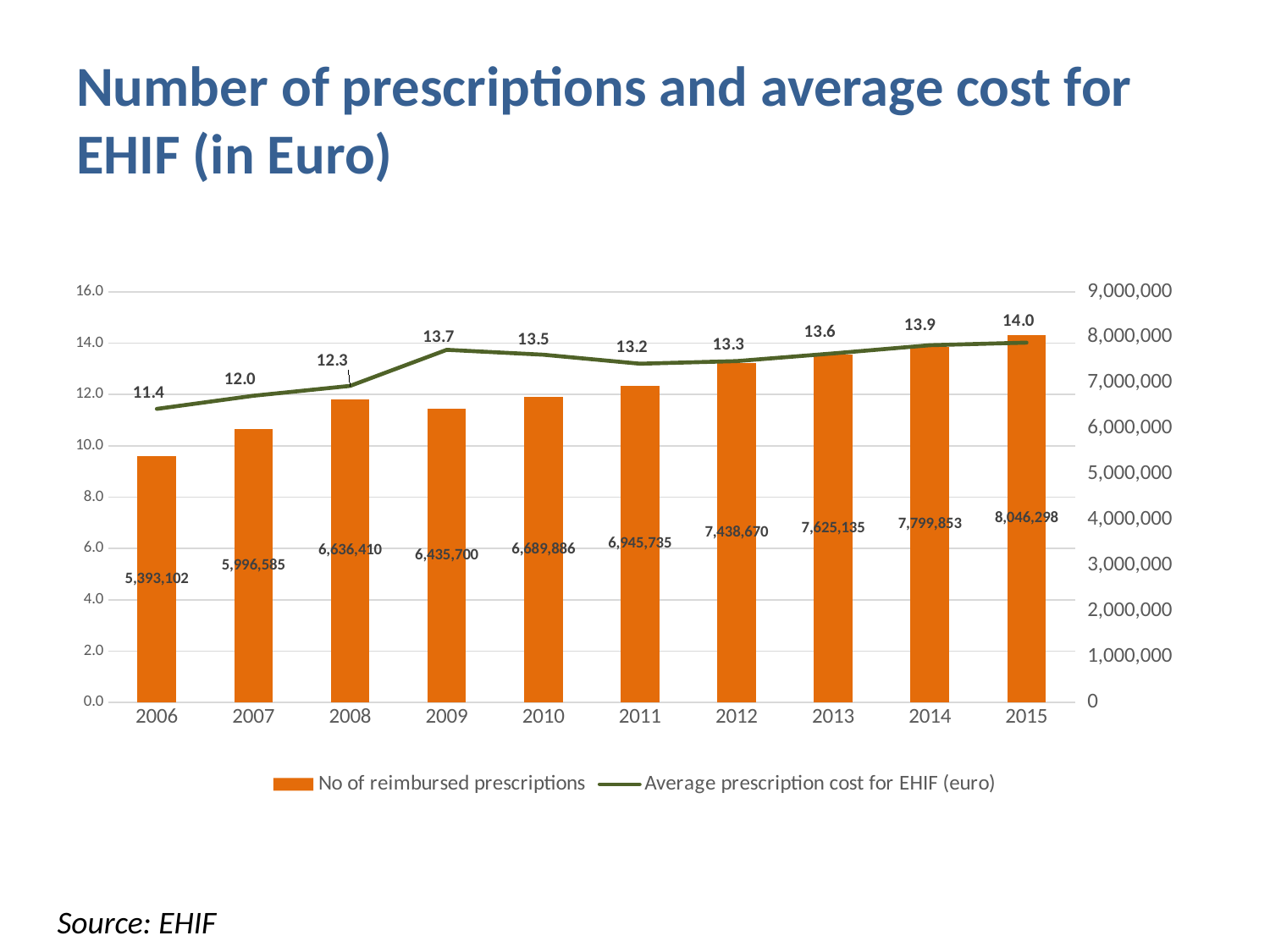
How many years are shown on the x axis? 10 How many reimbursed prescriptions were there in 2006? 5,393,102 What is the difference in the number of reimbursed prescriptions between 2015 and 2006? 2,653,196 What is the source cited for the chart? EHIF Which year had the highest number of reimbursed prescriptions? 2015 How many reimbursed prescriptions were there in 2012? 7,438,670 By how much did the average prescription cost for EHIF increase from 2008 to 2009? 1.4 How many series does the legend list? 2 Which year had more reimbursed prescriptions, 2008 or 2009? 2008 What kind of chart is shown on the slide? Combined bar and line chart What was the average prescription cost for EHIF in 2009? 13.7 Which year had the lowest average prescription cost for EHIF? 2006